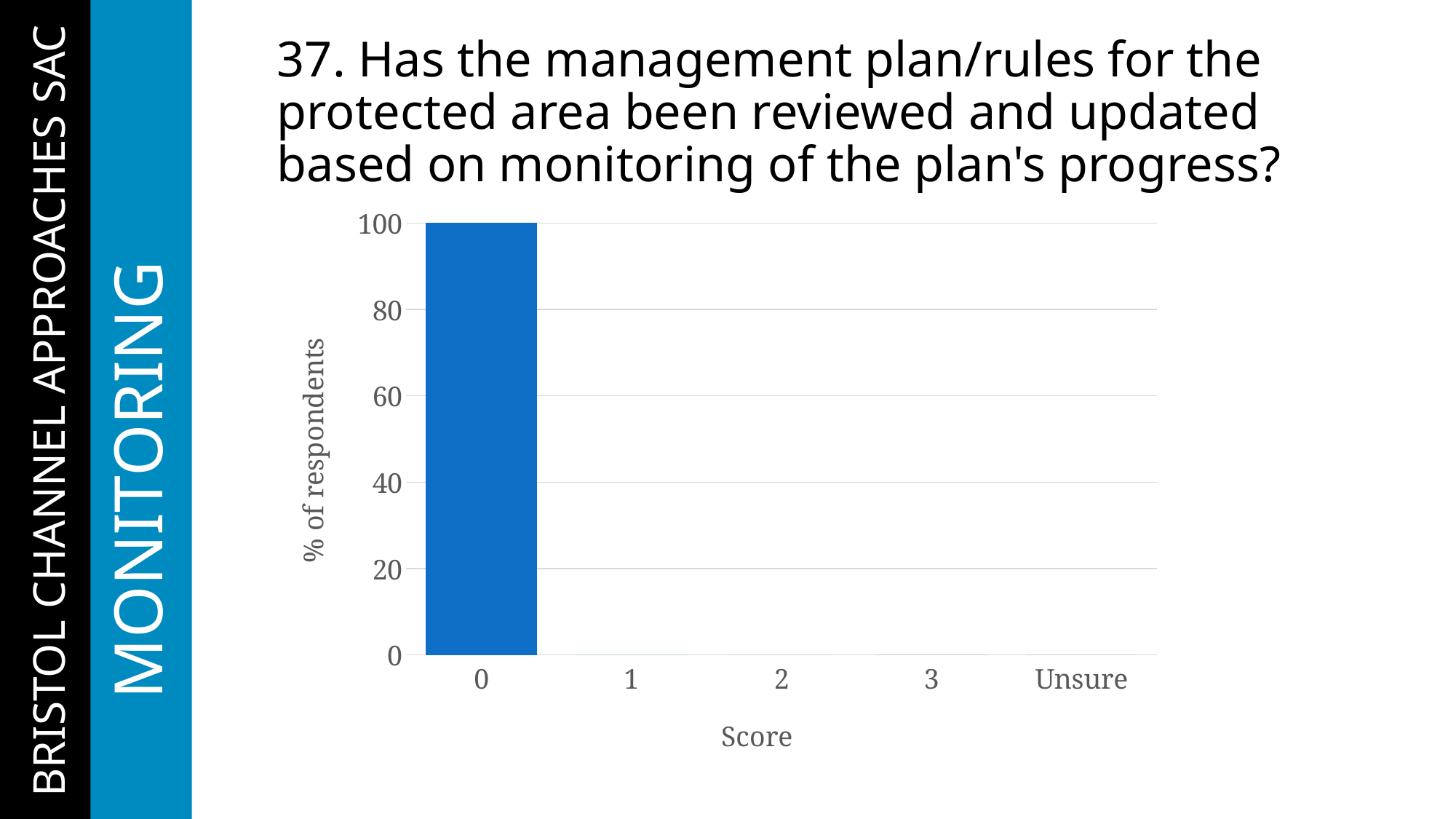
Do the values rise or fall from score 0 to score 1? fall What percentage of respondents answered Unsure? 0 What is the label of the y axis? % of respondents Which score category has the highest percentage of respondents? 0 What is the difference between the percentage for score 0 and the percentage for score 1? 100 Is the value for score 0 greater or less than 80? greater What kind of chart is shown on the slide? bar chart What percentage of respondents gave a score of 0? 100 Which is larger, the value for score 0 or the value for score 3? score 0 What is the label of the x axis? Score How many score categories are shown on the x axis? 5 What percentage of respondents gave a score of 2? 0